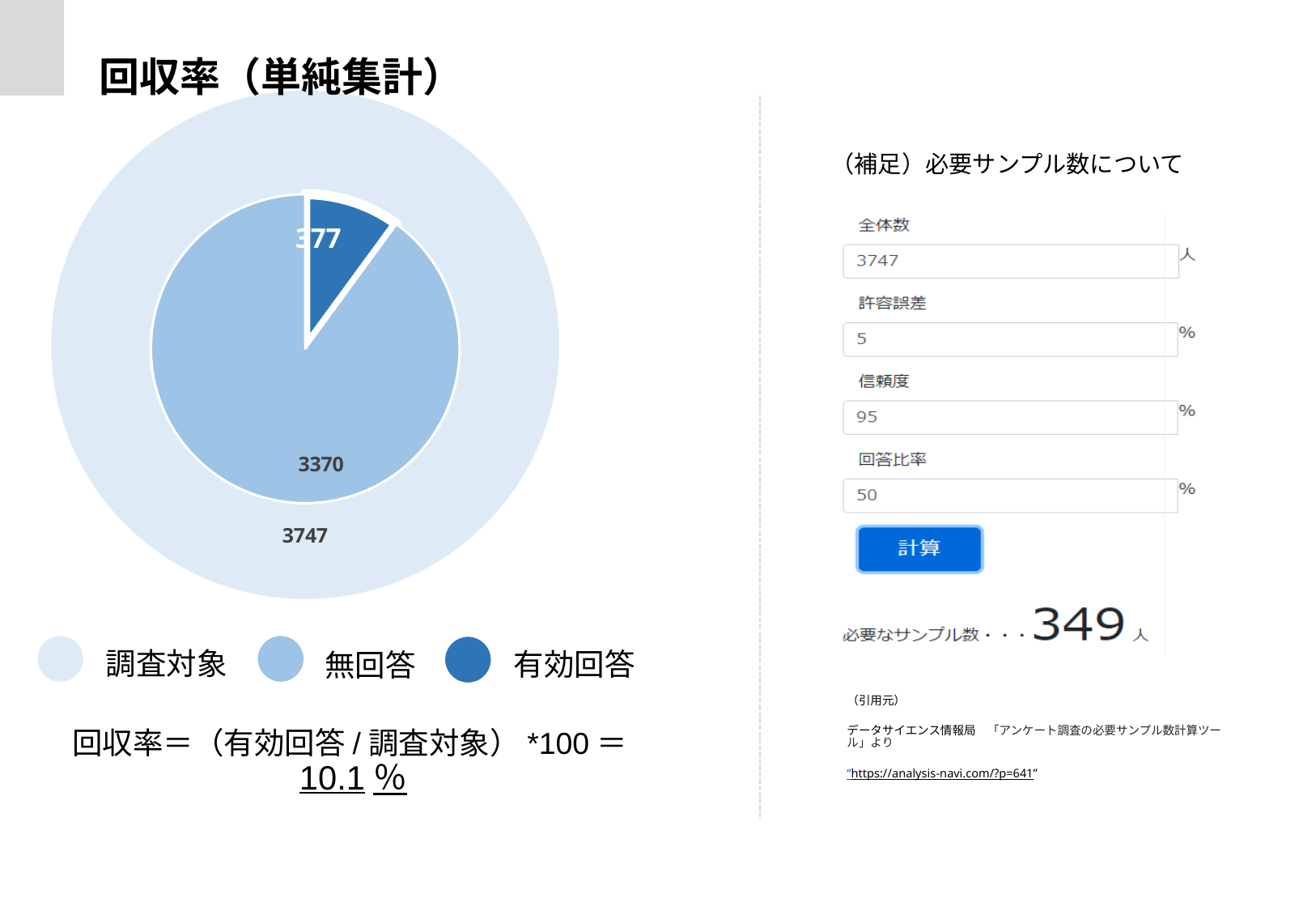
What is the difference between the value for 無回答 and the value for 有効回答? 2993 What is the title of the slide containing the pie chart? 回収率（単純集計） What is the 回収率 (recovery rate) stated below the chart? 10.1 % What is the value for 調査対象 shown on the chart? 3747 What is the total of 有効回答 and 無回答 in the pie chart? 3747 What is the value for 無回答 in the pie chart? 3370 What is the value for 有効回答 in the pie chart? 377 How many entries does the legend below the chart list? 3 Which is larger, the value for 無回答 or the value for 有効回答? 無回答 Which legend entry is shown in the darkest blue colour? 有効回答 Which category has the smaller value in the pie chart, 有効回答 or 無回答? 有効回答 What kind of chart is shown on the left of the slide? pie chart